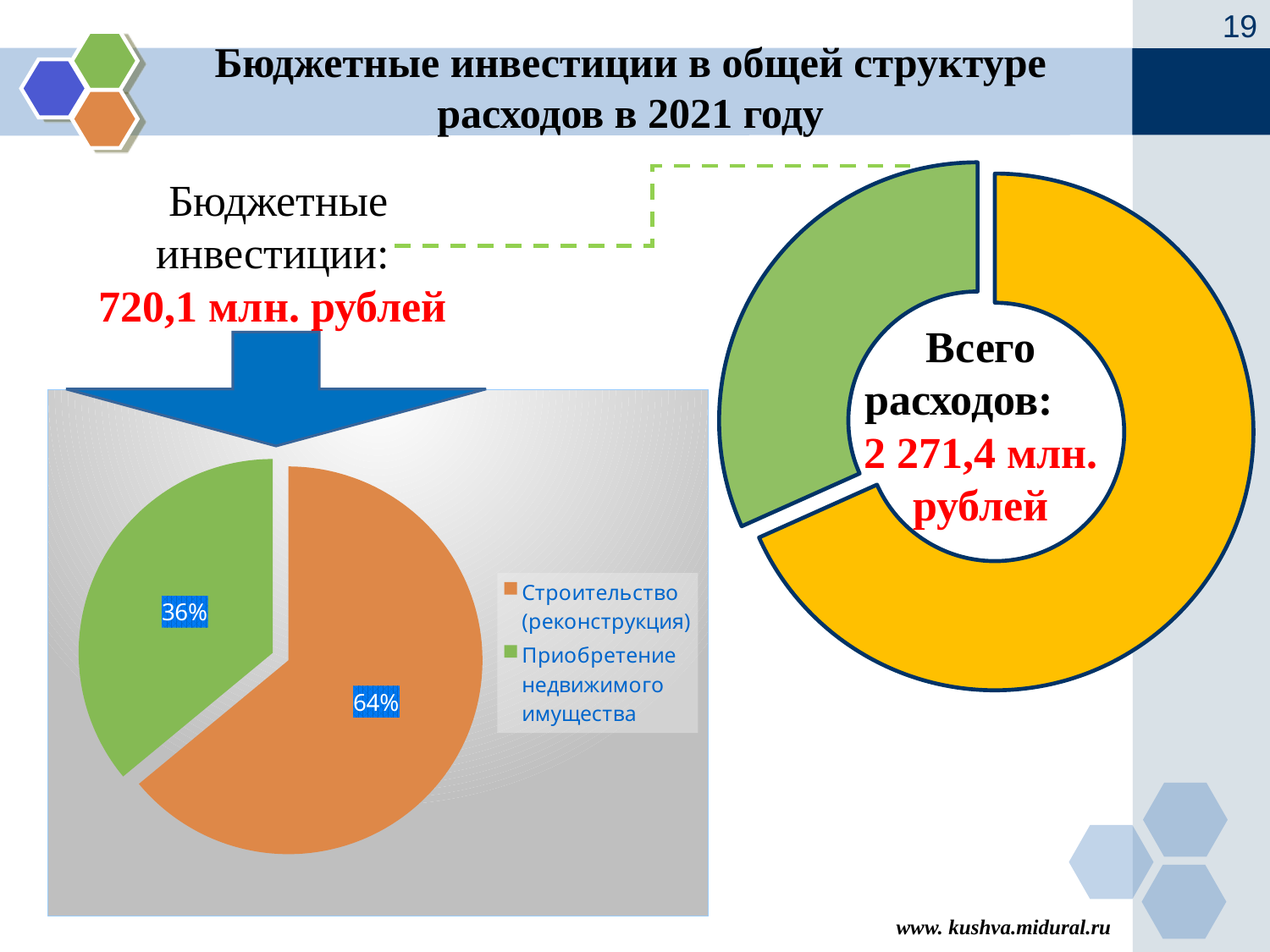
How many slices does the pie chart at the bottom left have? 2 In the pie chart at the bottom left, what share is labelled for Приобретение недвижимого имущества? 36% How many entries does the legend of the pie chart at the bottom left list? 2 In the pie chart at the bottom left, which slice is larger: Строительство (реконструкция) or Приобретение недвижимого имущества? Строительство (реконструкция) What type of chart is shown at the bottom left of the slide? Pie chart In the pie chart at the bottom left, what is the difference in percentage points between the Строительство (реконструкция) slice and the Приобретение недвижимого имущества slice? 28 percentage points In the pie chart at the bottom left, which category has the smallest slice? Приобретение недвижимого имущества In the pie chart at the bottom left, what share is labelled for Строительство (реконструкция)? 64% What type of chart is shown on the right side of the slide? Doughnut chart In the pie chart at the bottom left, what colour is the Приобретение недвижимого имущества slice? Green In the pie chart at the bottom left, which category has the largest slice? Строительство (реконструкция) What total value is printed in the centre of the doughnut chart on the right? 2 271,4 млн. рублей